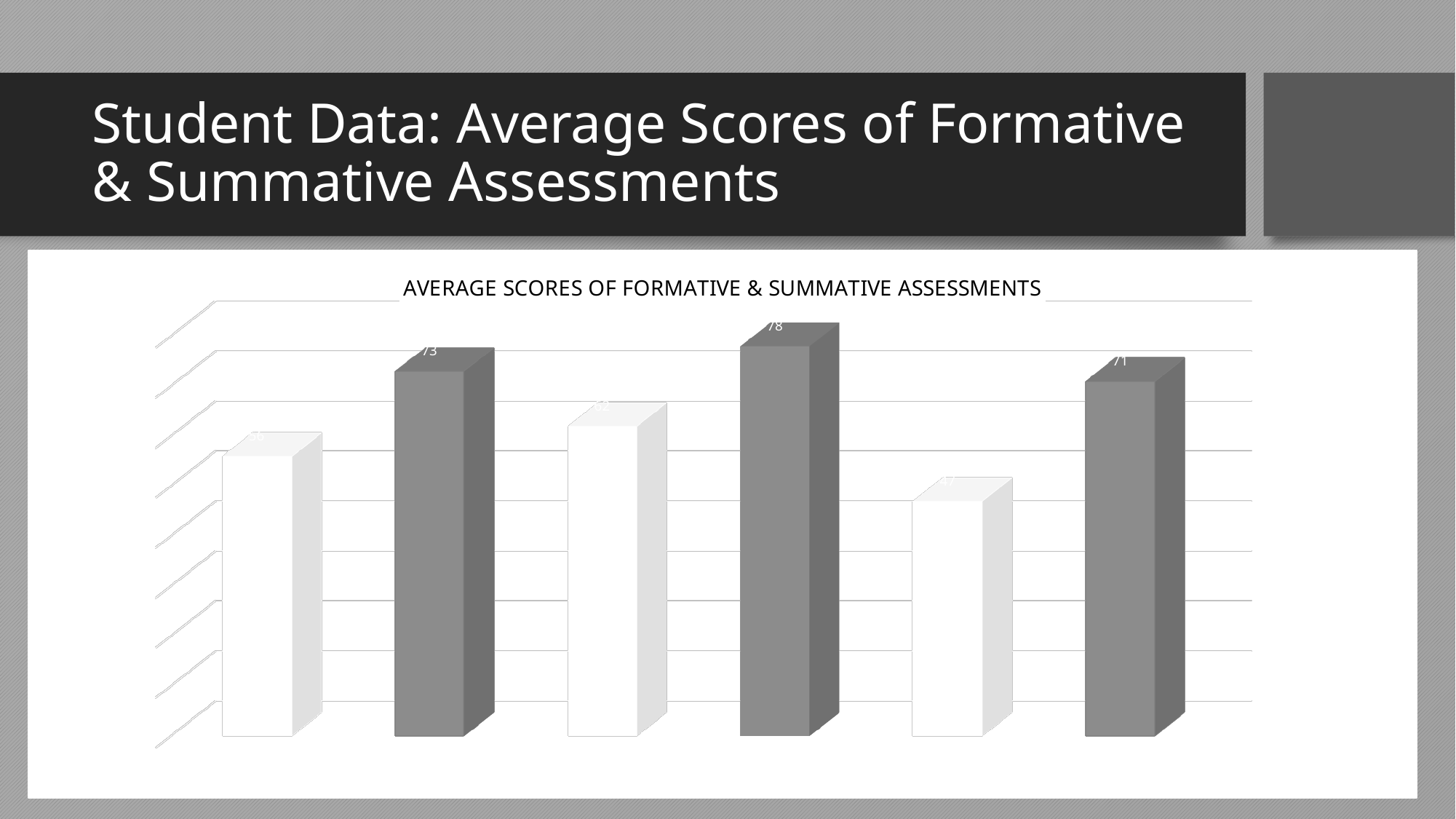
What is the difference between the fourth bar (78) and the second bar (73)? 5 What is the value shown on the rightmost bar? 71 How many bars are plotted in the chart? 6 What kind of chart is shown on the slide? bar chart What is the value shown on the fourth bar from the left? 78 What is the value shown on the second bar from the left? 73 What is the lowest value shown on any bar in the chart? 47 What is the highest value shown on any bar in the chart? 78 What is the title of the chart? AVERAGE SCORES OF FORMATIVE & SUMMATIVE ASSESSMENTS What is the value shown on the fifth bar from the left? 47 What is the value shown on the third bar from the left? 62 Which is larger, the value of the second bar from the left or the third bar from the left? the second bar (73)